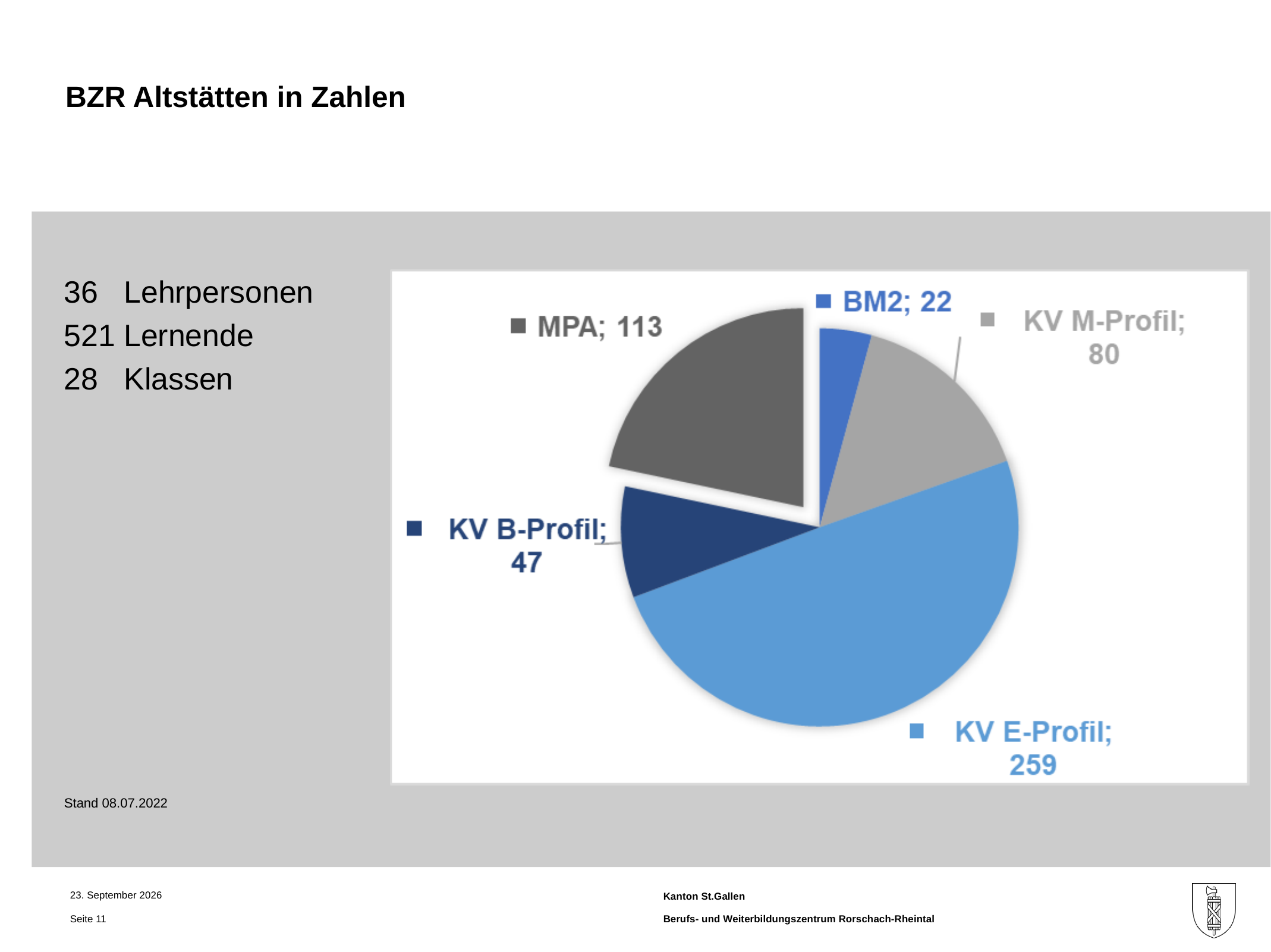
What type of chart is shown on the slide? pie chart What is the difference between the values for KV E-Profil and MPA? 146 What is the value for MPA in the pie chart? 113 What is the total of all slices in the pie chart? 521 Which is larger, KV M-Profil or KV B-Profil? KV M-Profil Which category has the smallest slice in the pie chart? BM2 Which slice is pulled out (exploded) from the rest of the pie? MPA What is the difference between the values for KV B-Profil and BM2? 25 Which category has the largest slice in the pie chart? KV E-Profil What is the value for KV E-Profil in the pie chart? 259 What is the value for BM2 in the pie chart? 22 How many slices does the pie chart have? 5